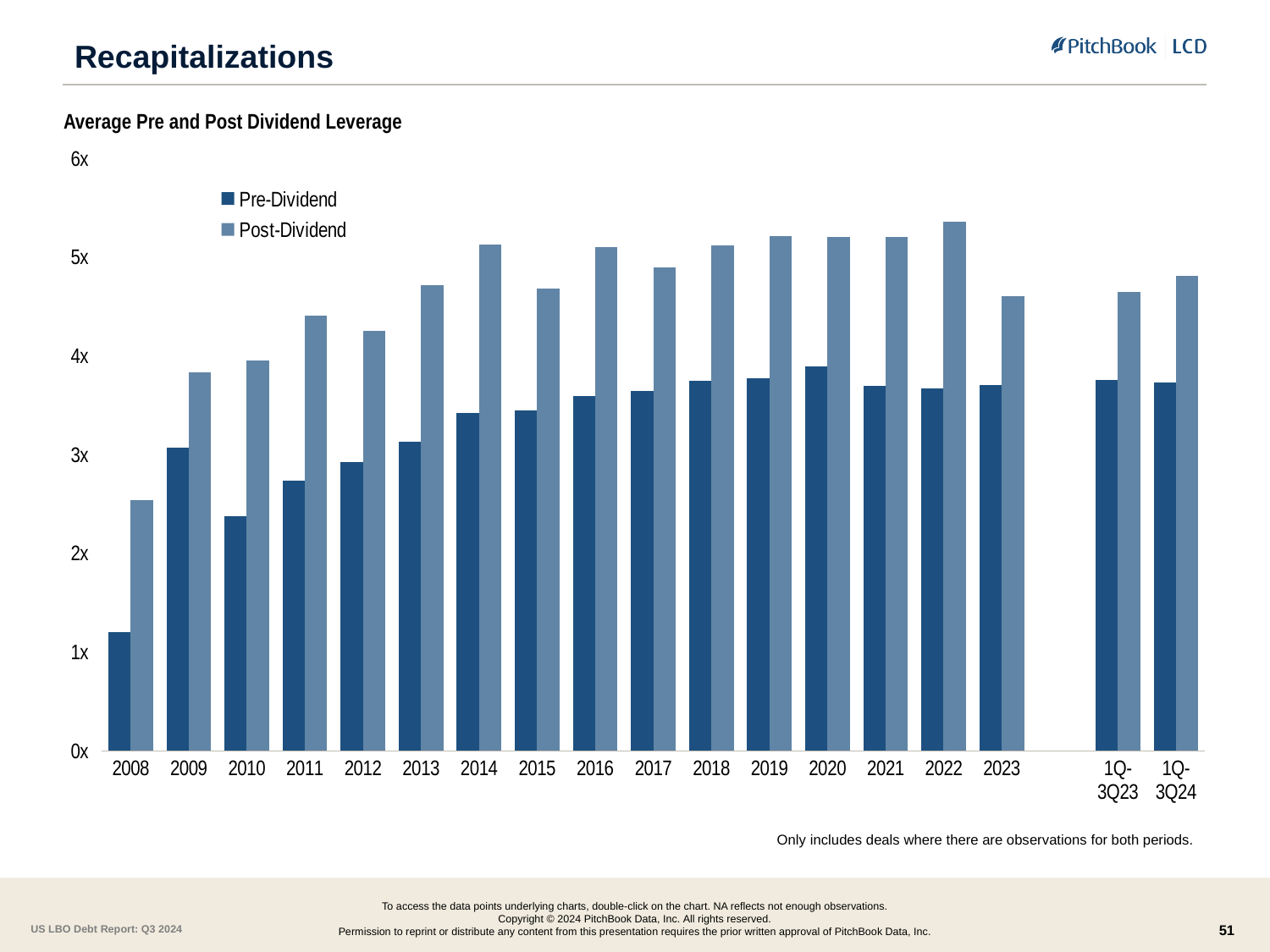
How many categories are shown along the x axis? 18 Is the Pre-Dividend value for 2008 greater or less than 2x? less Is the Post-Dividend value for 2023 greater or less than 5x? less Do the Post-Dividend values rise or fall from 2008 to 2011? Rise What are the two series named in the legend? Pre-Dividend and Post-Dividend Which category has the lowest Post-Dividend value? 2008 Is the Post-Dividend value for 2022 greater or less than 5x? greater Which category has the lowest Pre-Dividend value? 2008 Which category has the highest Post-Dividend value? 2022 What kind of chart is shown on the slide? Bar chart How many series does the legend list? 2 Which is larger, the Post-Dividend value for 2011 or for 2012? 2011